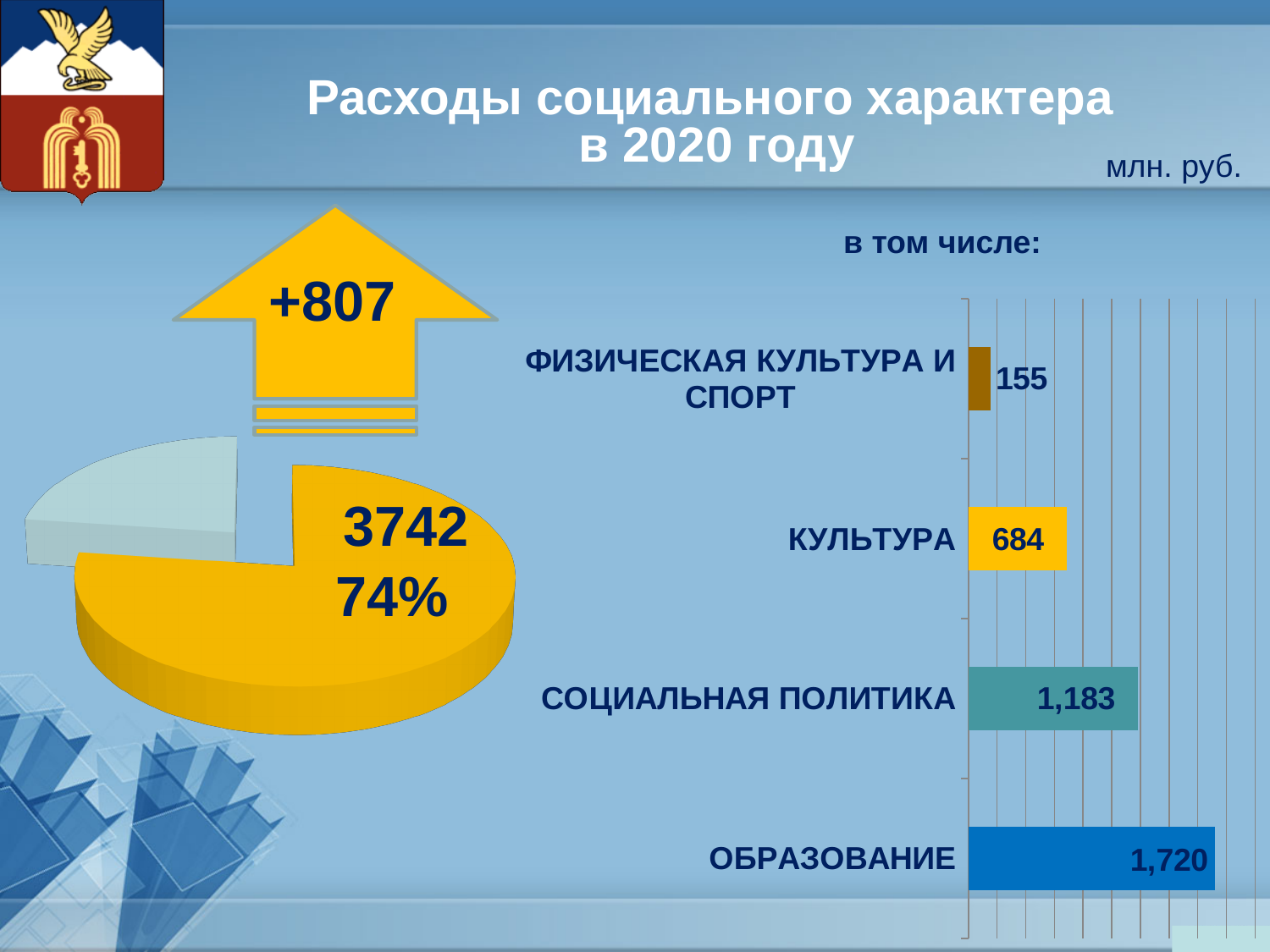
In the bar chart on the right, what is the value for ОБРАЗОВАНИЕ? 1,720 In the bar chart on the right, which category has the lowest value? ФИЗИЧЕСКАЯ КУЛЬТУРА И СПОРТ In the bar chart on the right, which is larger: the value for СОЦИАЛЬНАЯ ПОЛИТИКА or the value for КУЛЬТУРА? СОЦИАЛЬНАЯ ПОЛИТИКА In the pie chart on the left, what share of the pie does the yellow slice labelled 3742 represent? 74% How many categories does the bar chart on the right show? 4 In the bar chart on the right, what is the difference between the values for КУЛЬТУРА and ФИЗИЧЕСКАЯ КУЛЬТУРА И СПОРТ? 529 In the bar chart on the right, what is the value for КУЛЬТУРА? 684 In the bar chart on the right, what is the value for СОЦИАЛЬНАЯ ПОЛИТИКА? 1,183 In the bar chart on the right, which category has the highest value? ОБРАЗОВАНИЕ In the bar chart on the right, what is the difference between the values for ОБРАЗОВАНИЕ and СОЦИАЛЬНАЯ ПОЛИТИКА? 537 What kind of chart is shown on the right side of the slide? Bar chart In the bar chart on the right, what is the value for ФИЗИЧЕСКАЯ КУЛЬТУРА И СПОРТ? 155